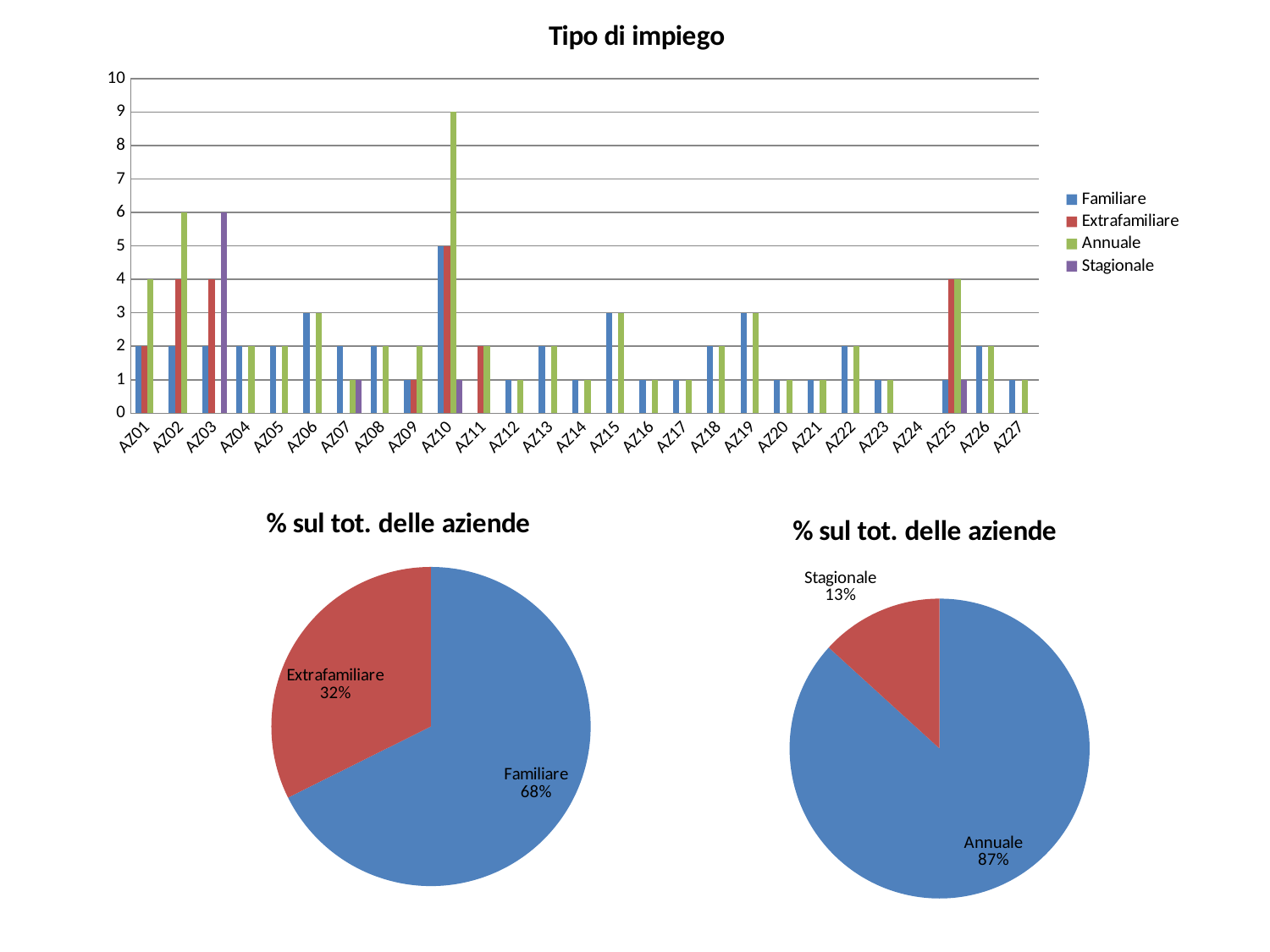
In the 'Tipo di impiego' bar chart, how many categories are shown on the x axis? 27 In the 'Tipo di impiego' bar chart, how many series does the legend list? 4 In the 'Tipo di impiego' bar chart, which category has the highest Annuale value? AZ10 In the right pie chart '% sul tot. delle aziende', which slice is larger, Annuale or Stagionale? Annuale In the left pie chart '% sul tot. delle aziende', what is the difference between the Familiare and Extrafamiliare shares? 36% In the right pie chart '% sul tot. delle aziende', what share does Stagionale have? 13% In the 'Tipo di impiego' bar chart, what is the Extrafamiliare value for AZ25? 4 What kind of chart is the 'Tipo di impiego' chart at the top of the slide? Bar chart In the left pie chart '% sul tot. delle aziende', what share does Familiare have? 68% In the 'Tipo di impiego' bar chart, what is the Stagionale value for AZ03? 6 In the 'Tipo di impiego' bar chart, what is the Annuale value for AZ10? 9 In the 'Tipo di impiego' bar chart, is the Annuale value for AZ02 greater or less than 5? greater